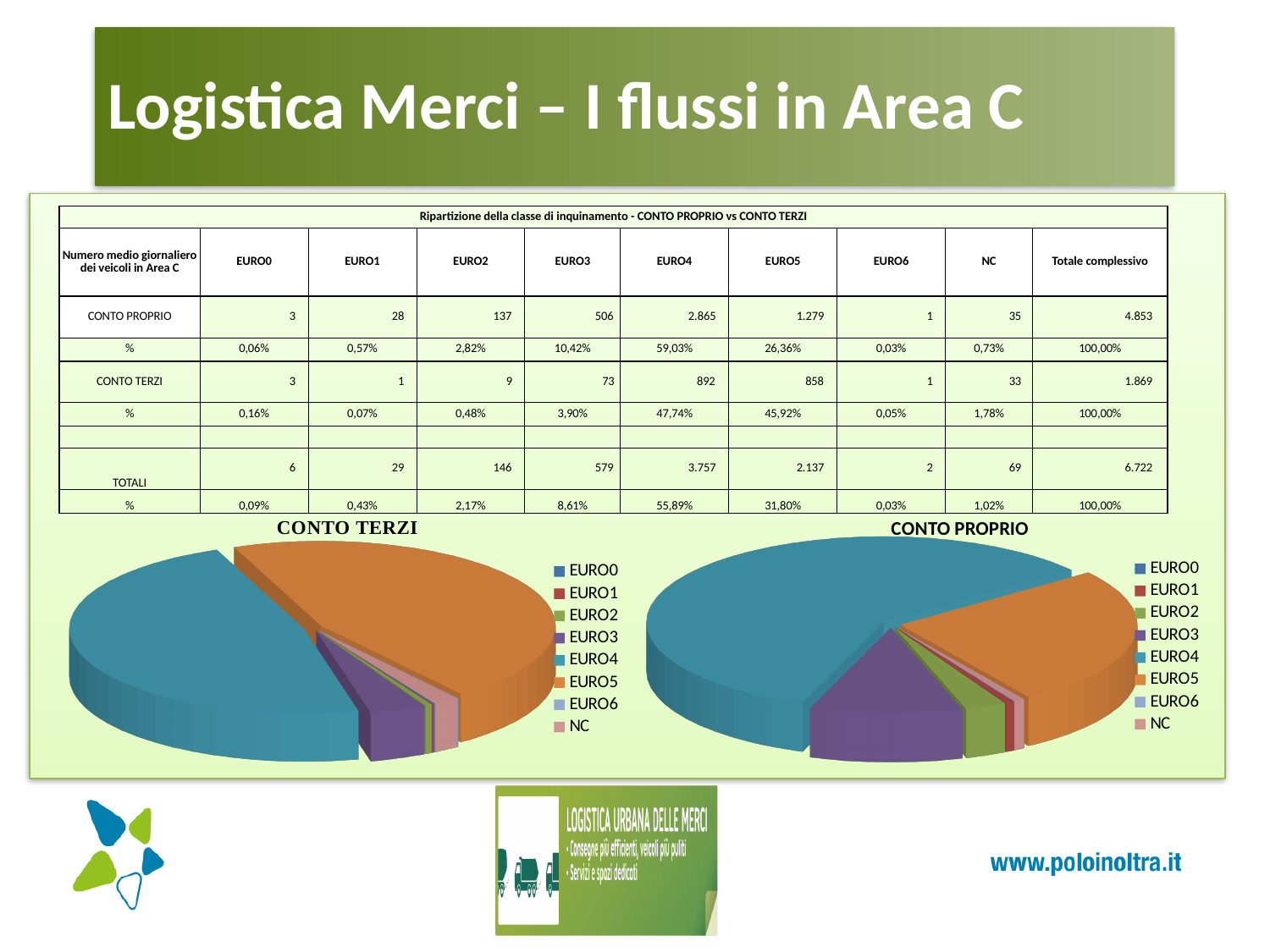
In the CONTO TERZI chart, which slice is larger, EURO5 or EURO3? EURO5 In the CONTO PROPRIO chart, which slice is larger, EURO4 or EURO5? EURO4 What is the title of the pie chart on the right side of the slide? CONTO PROPRIO How many entries does the legend of the CONTO TERZI chart list? 8 According to the table on the slide, what share of the CONTO PROPRIO pie does EURO4 represent? 59,03% Which legend entry is listed last in the CONTO TERZI chart? NC What kind of chart is the CONTO TERZI chart? pie chart In the CONTO PROPRIO chart, which category has the largest slice? EURO4 In the CONTO TERZI chart, which slice is larger, EURO3 or EURO2? EURO3 What kind of chart is the CONTO PROPRIO chart? pie chart According to the table on the slide, what share of the CONTO TERZI pie does EURO5 represent? 45,92% How many entries does the legend of the CONTO PROPRIO chart list? 8